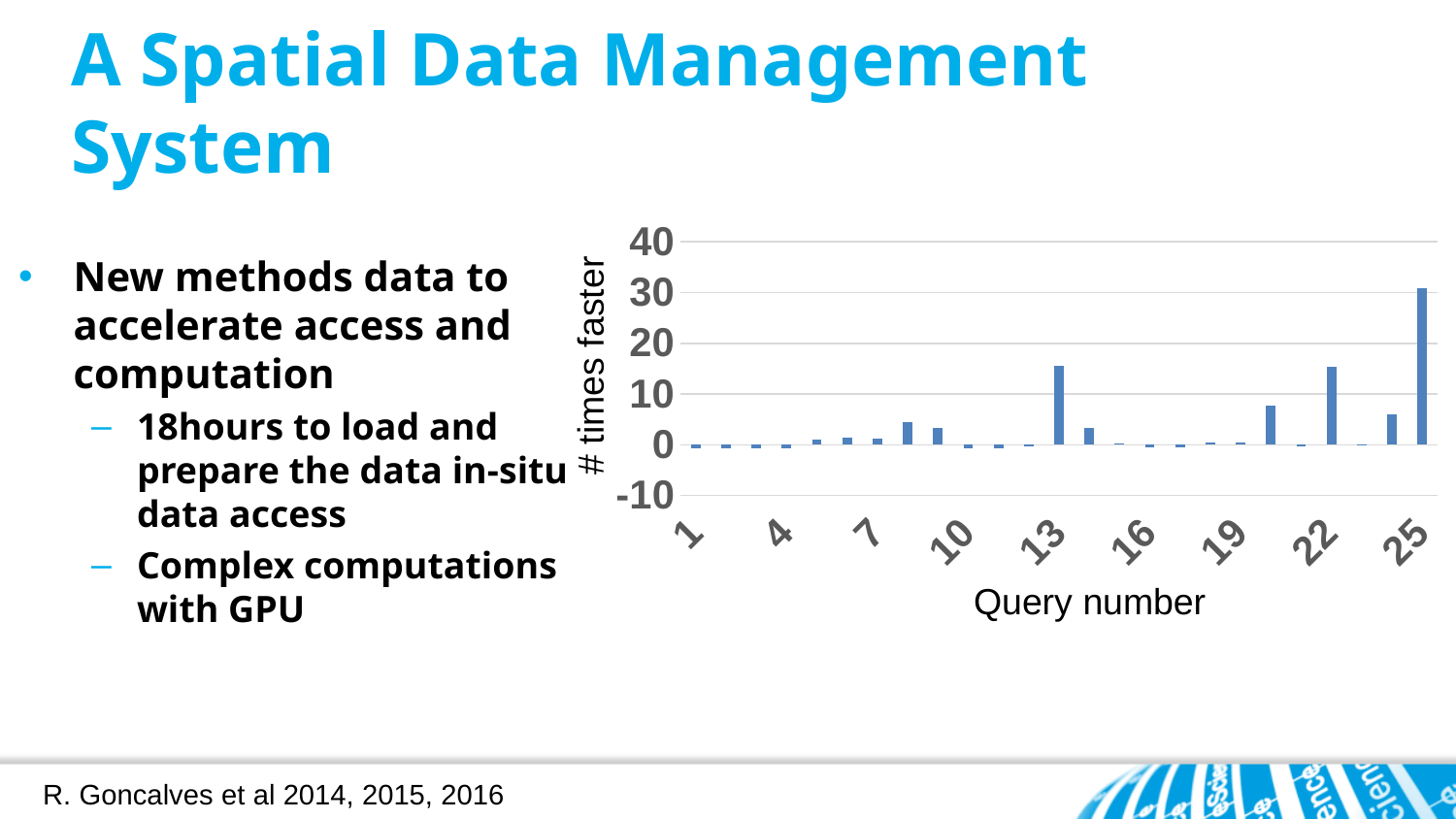
Which query number has the highest value in the chart? 25 Is the value for query 22 greater or less than 10? greater Which has the larger value, query 13 or query 20? query 13 What is the highest value shown on the y axis of the chart? 40 Which has the larger value, query 25 or query 13? query 25 Is the value for query 1 greater or less than 10? less What is the label of the x axis of the chart? Query number What kind of chart is shown on the slide? bar chart How many query numbers are plotted in the chart? 25 Is the value for query 25 greater or less than 20? greater What is the label of the y axis of the chart? # times faster